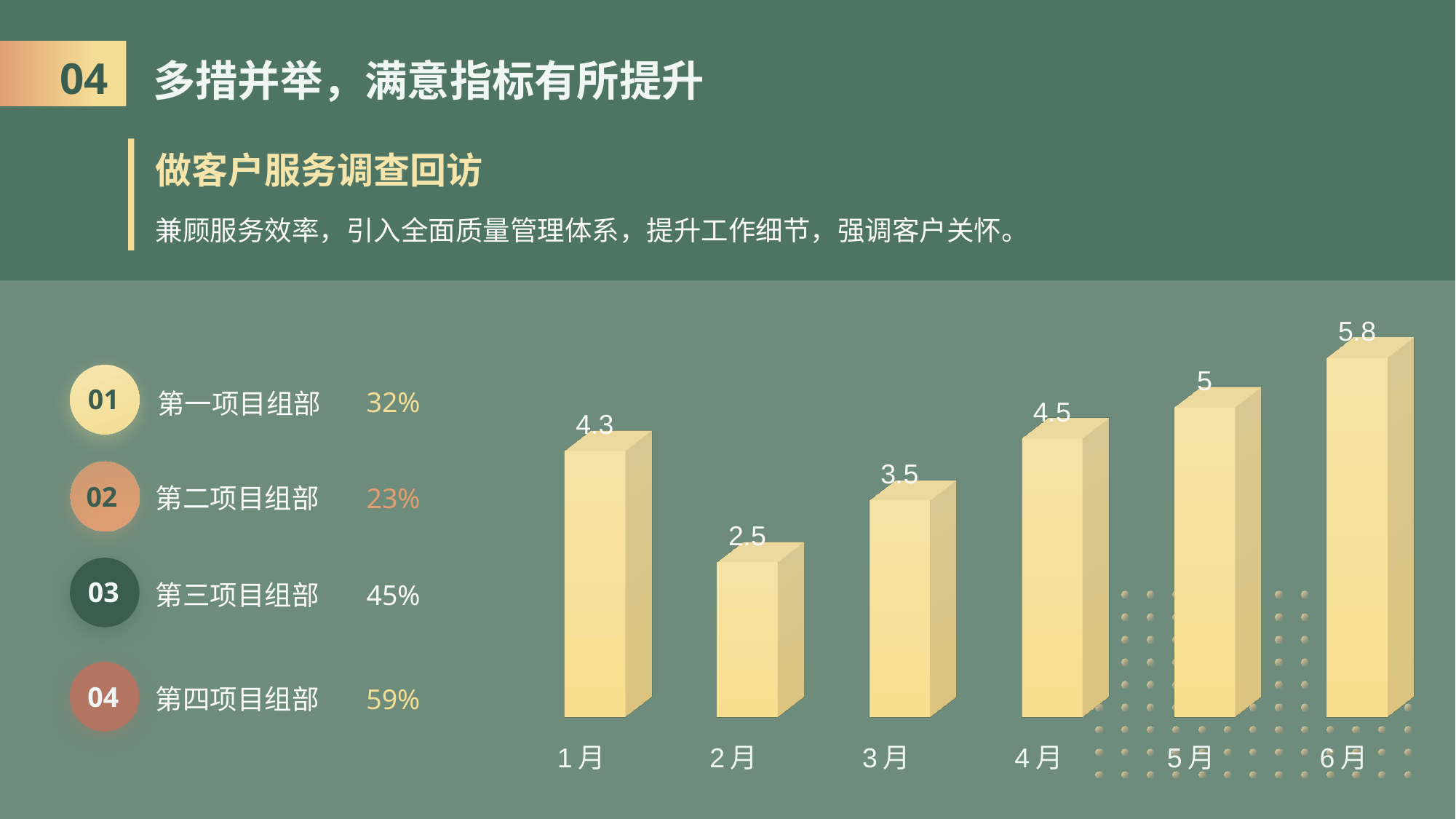
Which month has the highest value? 6月 What is the difference between the values for 6月 and 1月? 1.5 What is the difference between the values for 3月 and 2月? 1 What is the value for 6月? 5.8 What is the value for 1月? 4.3 Which month has the lowest value? 2月 What kind of chart is shown on the slide? bar chart What is the value for 2月? 2.5 How many months are shown on the chart? 6 Do the values rise or fall from 2月 to 6月? rise Which is larger, the value for 1月 or the value for 3月? 1月 What is the value for 4月? 4.5